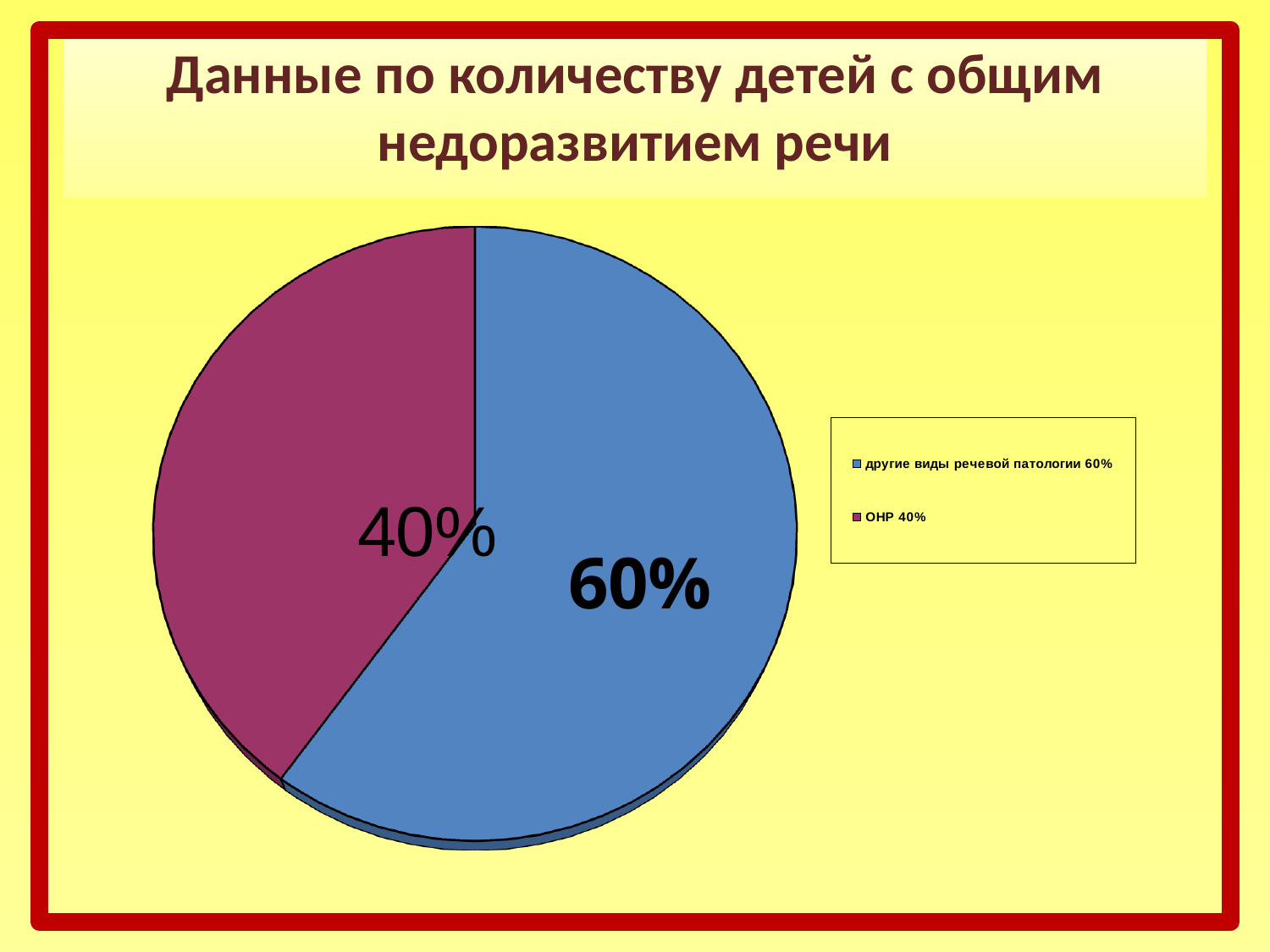
How many slices does the pie chart have? 2 How many entries does the legend list? 2 What is the difference in percentage points between the "другие виды речевой патологии" slice and the "ОНР" slice? 20% Which category has the smallest slice of the pie? ОНР What kind of chart is shown on the slide? pie chart Which is larger: the slice for "ОНР" or the slice for "другие виды речевой патологии"? другие виды речевой патологии What colour is the slice for "ОНР"? purple Which category has the largest slice of the pie? другие виды речевой патологии What is the title of the slide containing the chart? Данные по количеству детей с общим недоразвитием речи What share of the pie does the slice for "другие виды речевой патологии" represent? 60% What share of the pie does the slice for "ОНР" represent? 40%